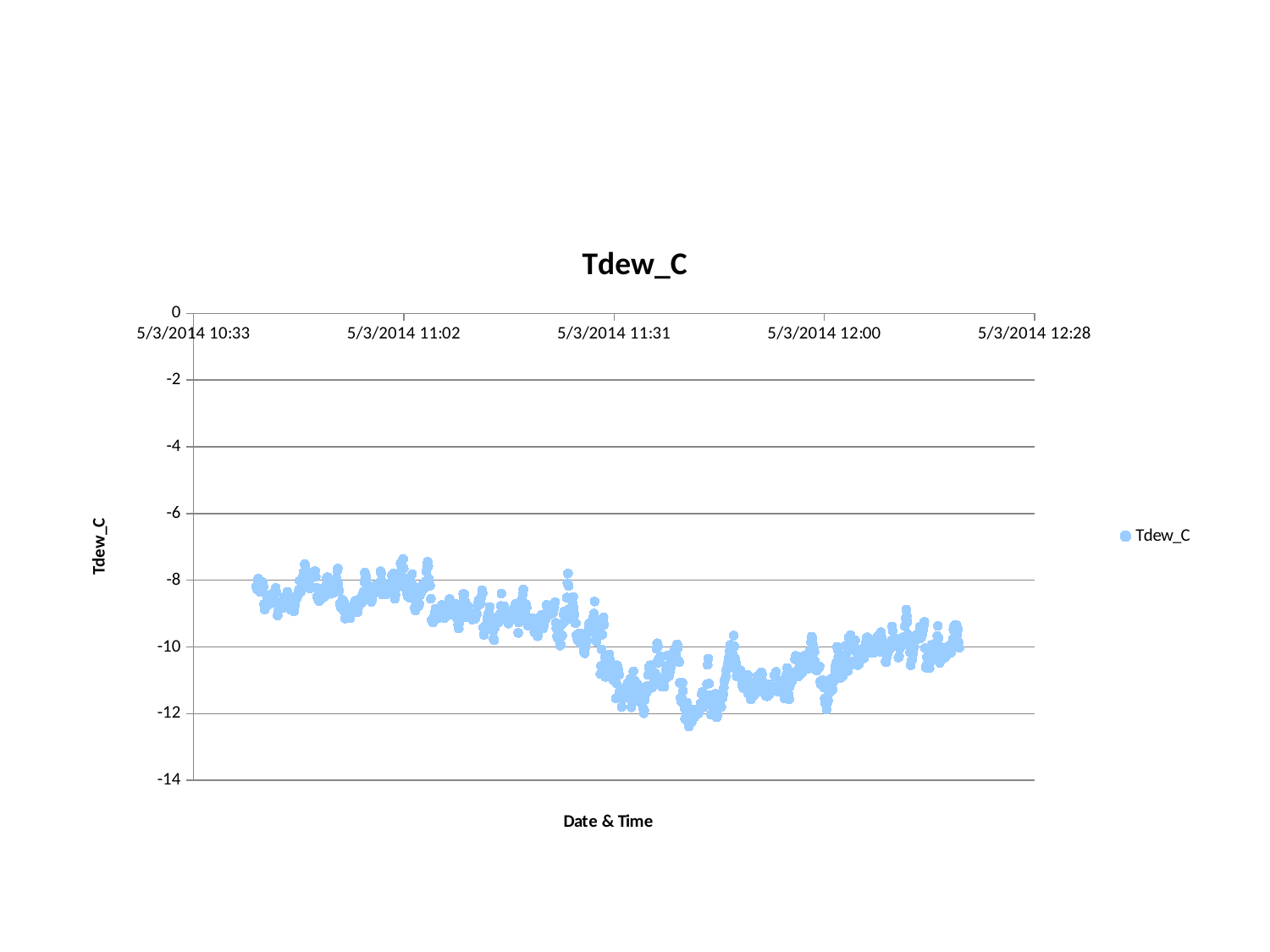
How many date-time tick labels are shown on the x axis? 5 Is the value for Tdew_C at 5/3/2014 12:00 greater or less than -10? less What is the label of the x axis? Date & Time What is the lowest tick value shown on the y axis? -14 Which is larger, the Tdew_C value at 5/3/2014 11:02 or at 5/3/2014 12:00? 5/3/2014 11:02 Is the value for Tdew_C at 5/3/2014 11:02 greater or less than -10? greater What kind of chart is shown on the slide? scatter chart Is the lowest Tdew_C value on the chart greater or less than -14? greater How many series does the legend list? 1 Do the Tdew_C values generally rise or fall from 5/3/2014 10:33 to around 5/3/2014 11:45? fall What is the title of the chart? Tdew_C